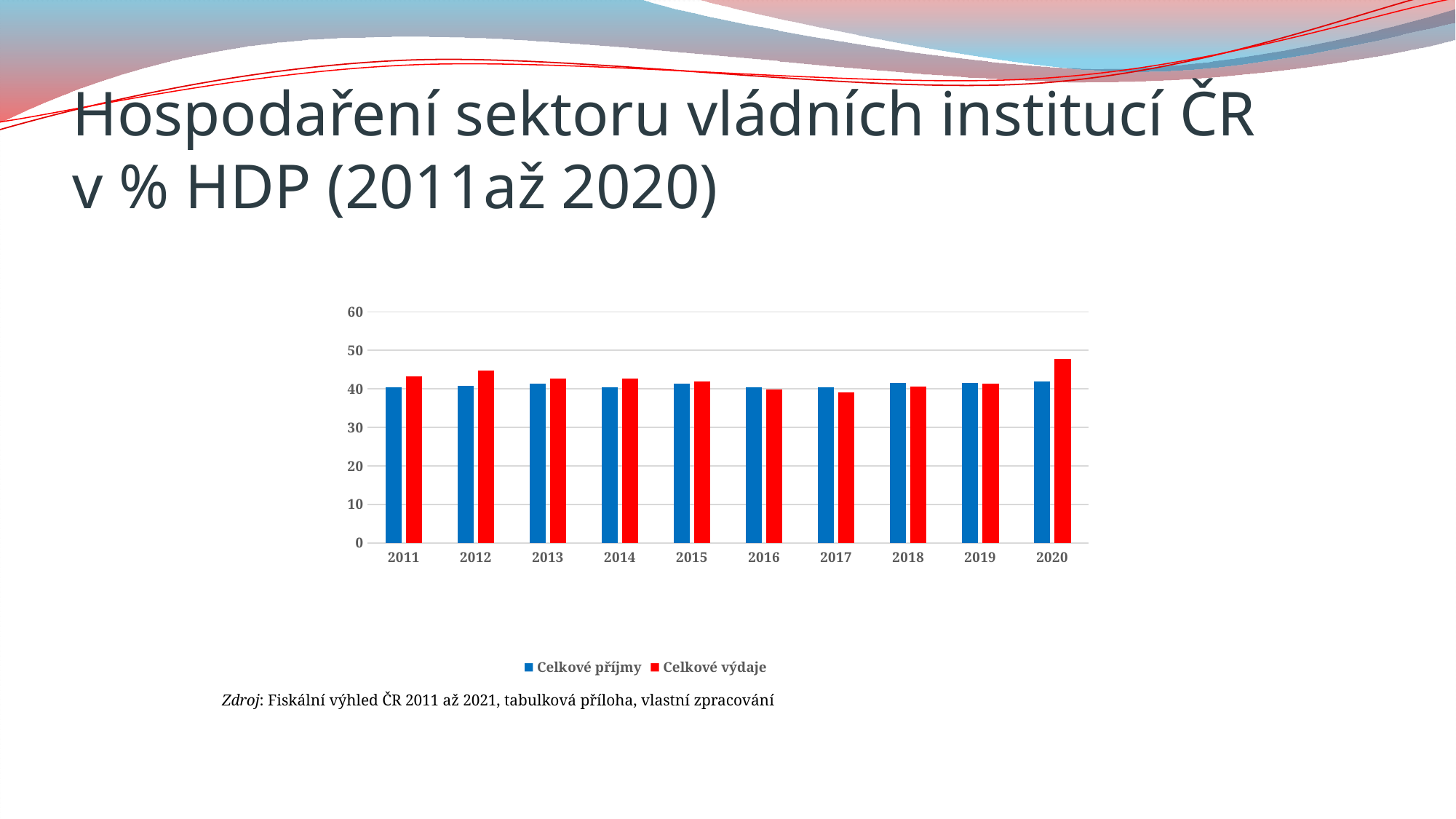
In which year is the value for Celkové výdaje the lowest? 2017 Is the value for Celkové výdaje in 2020 greater or less than 40? greater Is the value for Celkové výdaje in 2020 greater or less than 50? less What kind of chart is shown on the slide? bar chart In 2011, which is larger: Celkové příjmy or Celkové výdaje? Celkové výdaje How many series does the legend list? 2 In which year is the value for Celkové výdaje the highest? 2020 How many years are shown on the x axis of the chart? 10 What is the first year shown on the x axis of the chart? 2011 In 2012, which is larger: Celkové příjmy or Celkové výdaje? Celkové výdaje Which colour represents Celkové příjmy in the chart? blue Is the value for Celkové příjmy in 2016 greater or less than 30? greater